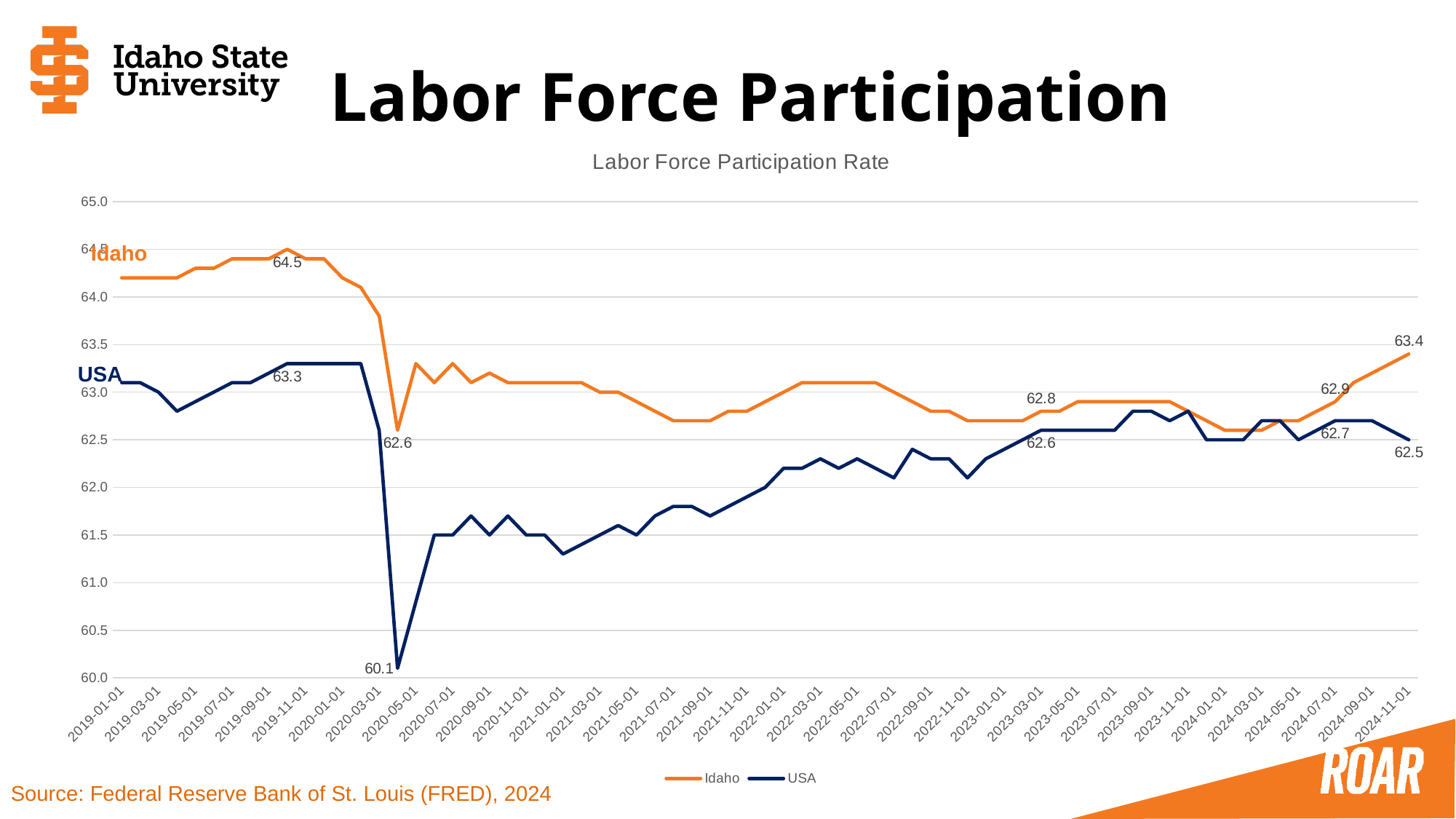
What is the USA labor force participation rate at the last point, 2024-11-01? 62.5 What is the title printed above the chart area? Labor Force Participation Rate Does the USA line rise or fall between 2021-01-01 and 2023-01-01? rise At 2024-11-01, which series has the higher value, Idaho or USA? Idaho What is the highest labeled value on the Idaho line? 64.5 At 2024-11-01, how much higher is the Idaho value than the USA value? 0.9 What is the lowest labeled value on the USA line? 60.1 What is the Idaho labor force participation rate at the last point, 2024-11-01? 63.4 Is the Idaho value at 2019-01-01 greater or less than 64.0? greater What kind of chart is shown on the slide? line chart Is the USA value at 2021-01-01 greater or less than 62.0? less How many series does the legend list? 2